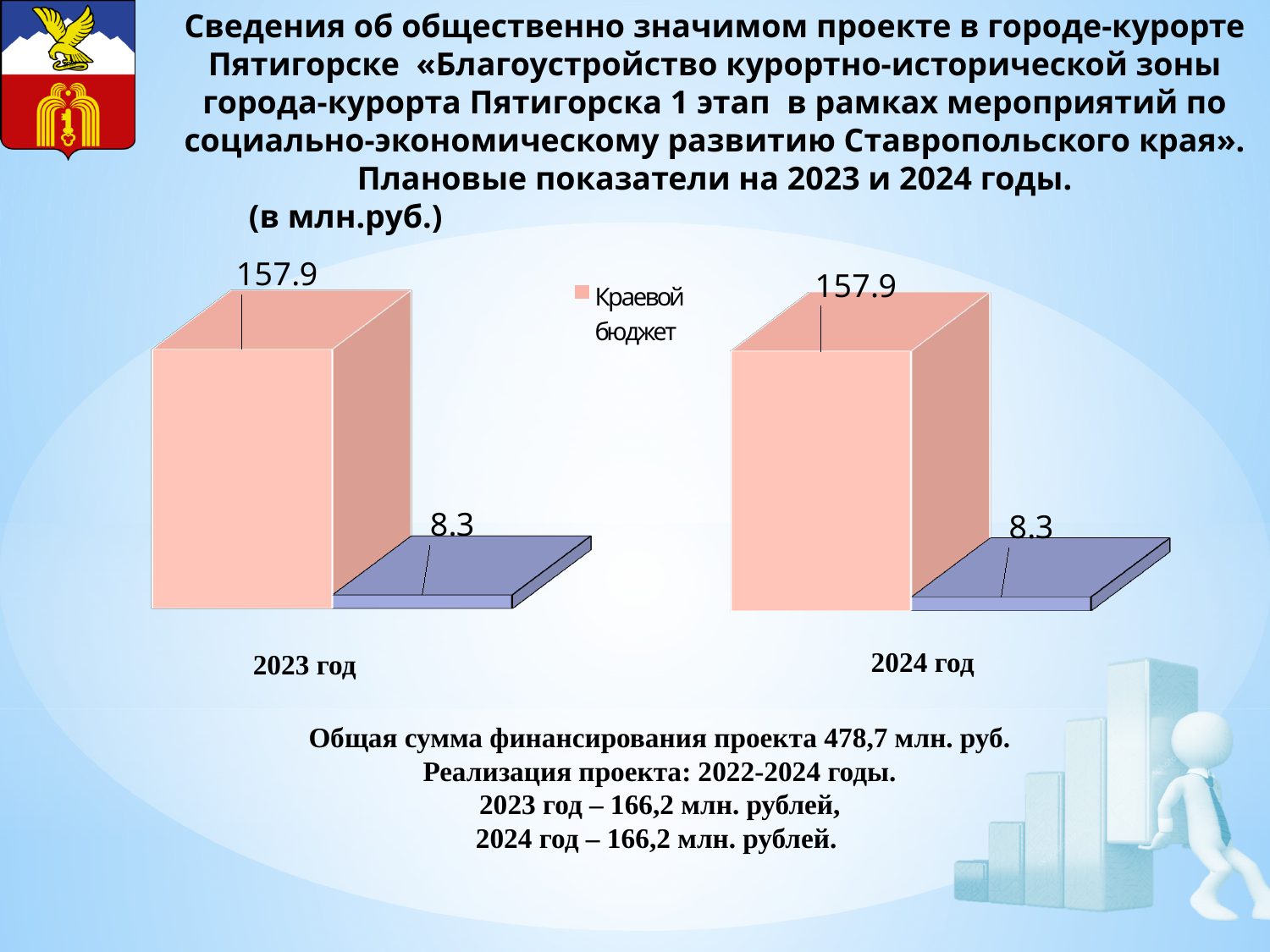
In the 2023 год chart, what is the value of the Краевой бюджет bar? 157.9 In the 2024 год chart, what is the value of the blue bar? 8.3 In the 2023 год chart, which bar has the lowest value? the blue bar (8.3) In the 2024 год chart, what is the value of the Краевой бюджет bar? 157.9 How many bars are plotted in the 2023 год chart? 2 In the 2024 год chart, what is the total of the two bars? 166.2 What colour is the Краевой бюджет bar in the 2023 год chart? pink In the 2023 год chart, what is the difference between the Краевой бюджет bar and the blue bar? 149.6 Which series name is shown in the legend of the 2023 год chart? Краевой бюджет In the 2023 год chart, what is the value of the blue bar? 8.3 In the 2024 год chart, which bar is larger, the Краевой бюджет bar or the blue bar? Краевой бюджет What type of chart is the 2024 год chart? bar chart